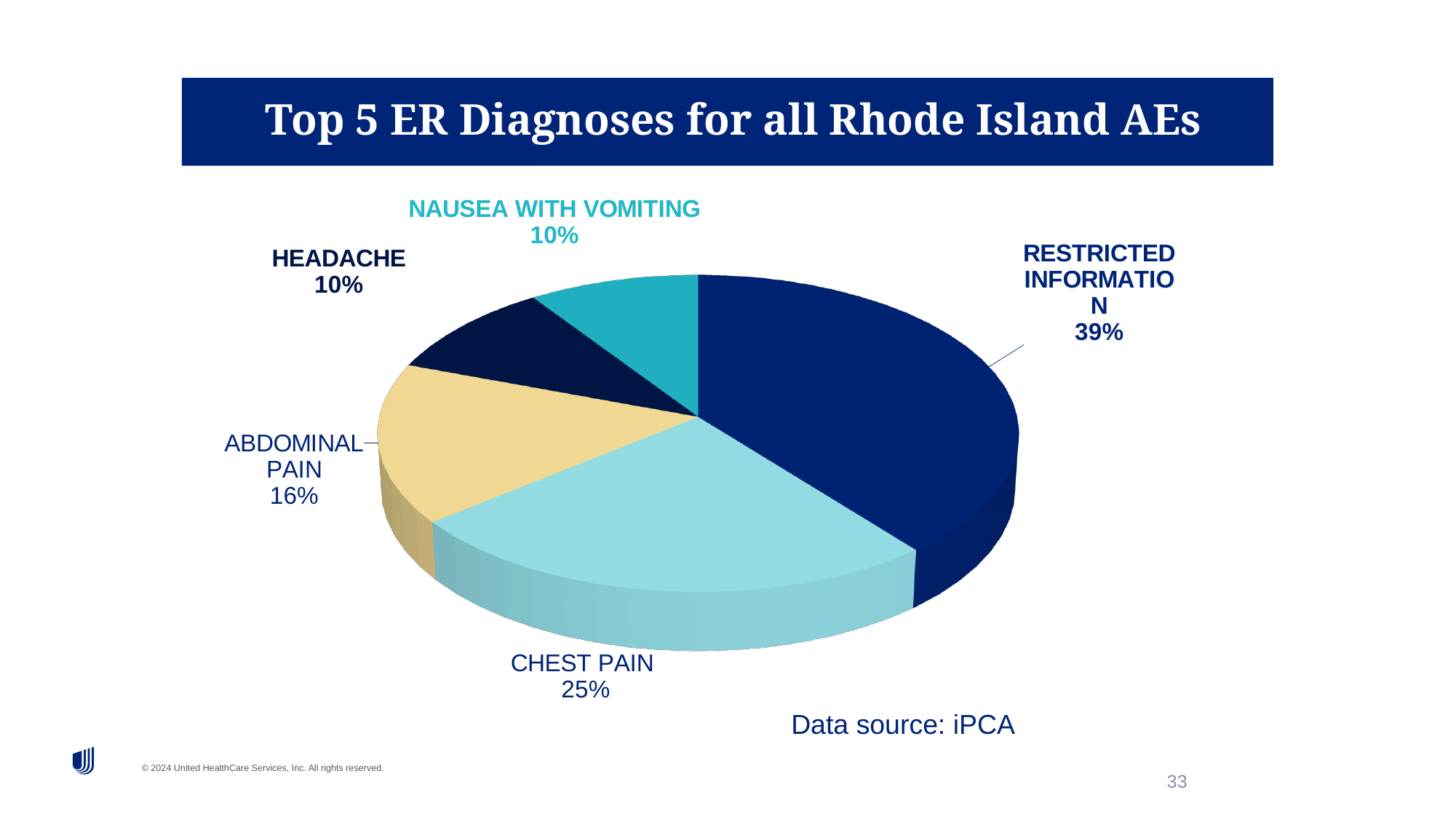
Which category has the largest slice of the pie? RESTRICTED INFORMATION What is the value shown for ABDOMINAL PAIN? 16% What is the title of the chart? Top 5 ER Diagnoses for all Rhode Island AEs What is the value shown for CHEST PAIN? 25% Which is larger, the share for CHEST PAIN or the share for ABDOMINAL PAIN? CHEST PAIN What data source is cited on the slide? iPCA What is the difference in percentage points between RESTRICTED INFORMATION and CHEST PAIN? 14 What share of the pie does RESTRICTED INFORMATION account for? 39% What kind of chart is shown on the slide? Pie chart What is the value shown for HEADACHE? 10% How many slices does the pie chart have? 5 What is the difference in percentage points between ABDOMINAL PAIN and NAUSEA WITH VOMITING? 6